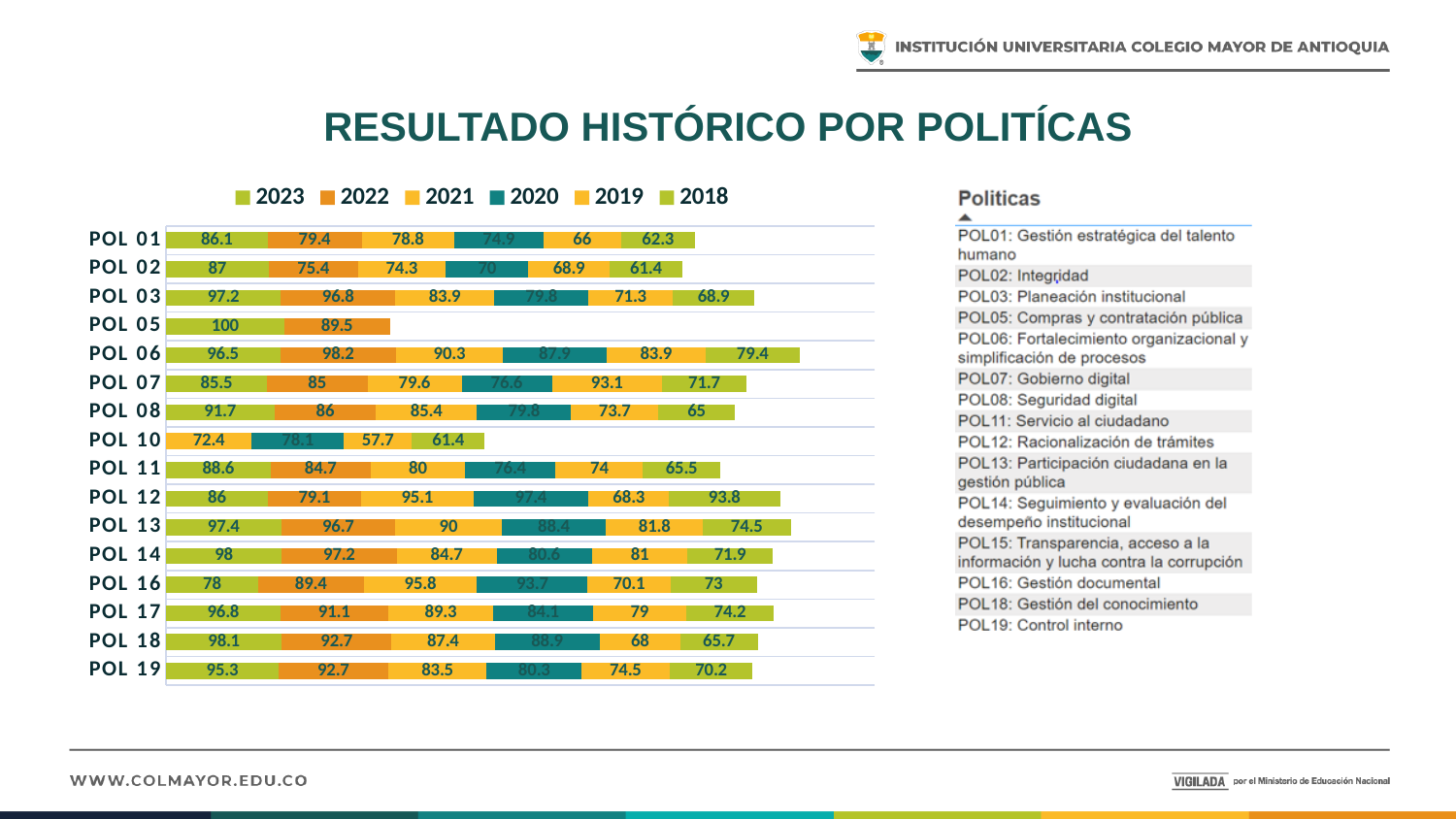
Which policy has the lowest 2023 value? POL 16 What is the 2023 value for POL 01? 86.1 How many series does the legend list? 6 What is the 2021 value for POL 16? 95.8 For POL 06, which is larger: the 2022 value or the 2023 value? 2022 How many policies (categories) are shown in the chart? 16 What is the title of the chart? RESULTADO HISTÓRICO POR POLITÍCAS What kind of chart is shown on the slide? Stacked bar chart Which policy has the highest 2023 value? POL 05 What is the 2019 value for POL 07? 93.1 What is the difference between the 2023 and 2018 values for POL 01? 23.8 What is the total of the stacked bar for POL 05? 189.5